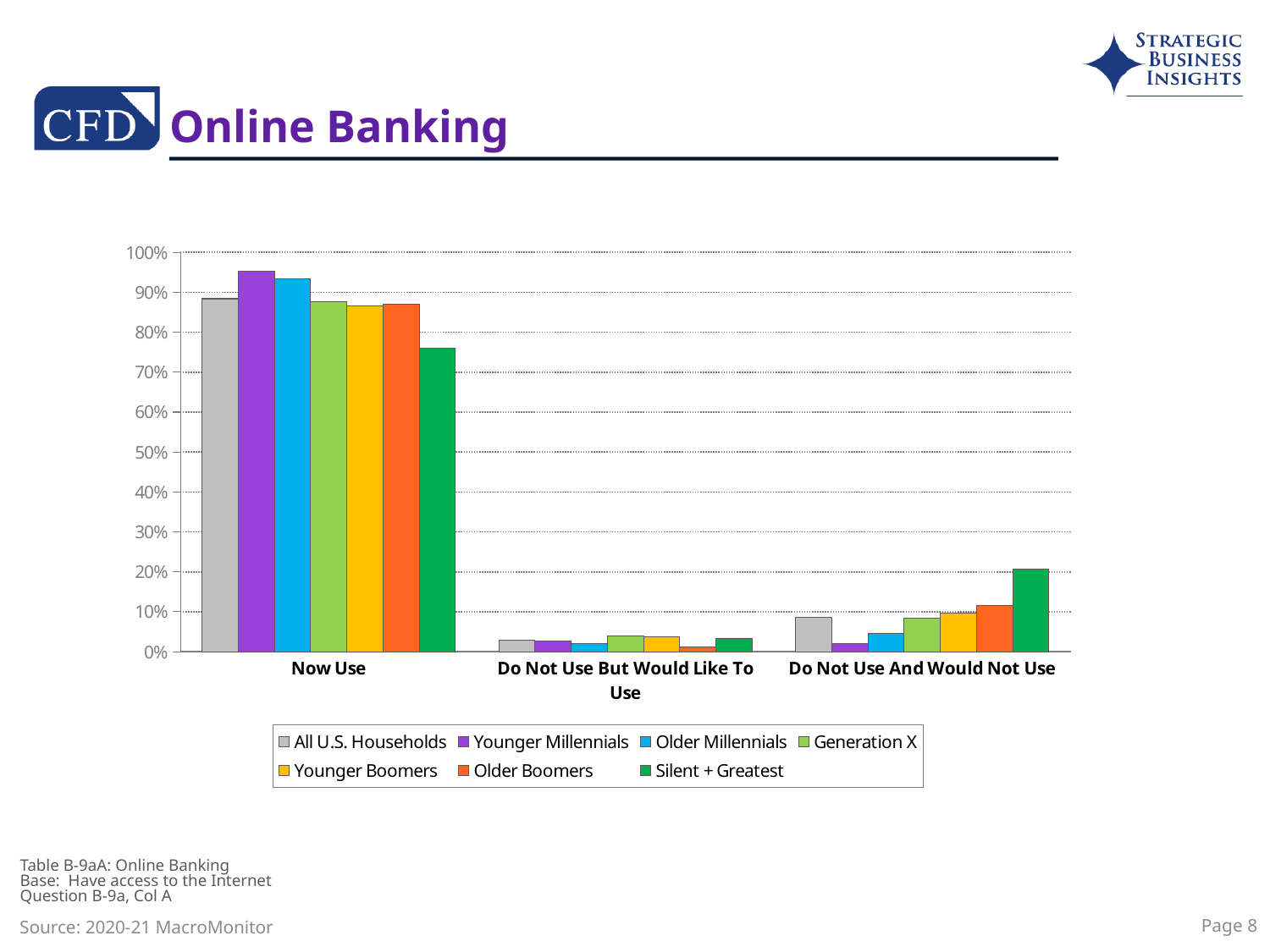
What kind of chart is shown on the slide? Bar chart How many categories are shown on the x axis? 3 In the Now Use category, which is larger: Younger Millennials or Silent + Greatest? Younger Millennials Is the Now Use value for Silent + Greatest greater or less than 80%? less In the Do Not Use And Would Not Use category, which series has the highest value? Silent + Greatest How many series does the legend list? 7 Is the Now Use value for Younger Millennials greater or less than 90%? greater In the Do Not Use But Would Like To Use category, which series has the lowest value? Older Boomers In the Do Not Use And Would Not Use category, which series has the lowest value? Younger Millennials In the Now Use category, which series has the lowest value? Silent + Greatest Is the Do Not Use And Would Not Use value for Silent + Greatest greater or less than 10%? greater In the Now Use category, which series has the highest value? Younger Millennials